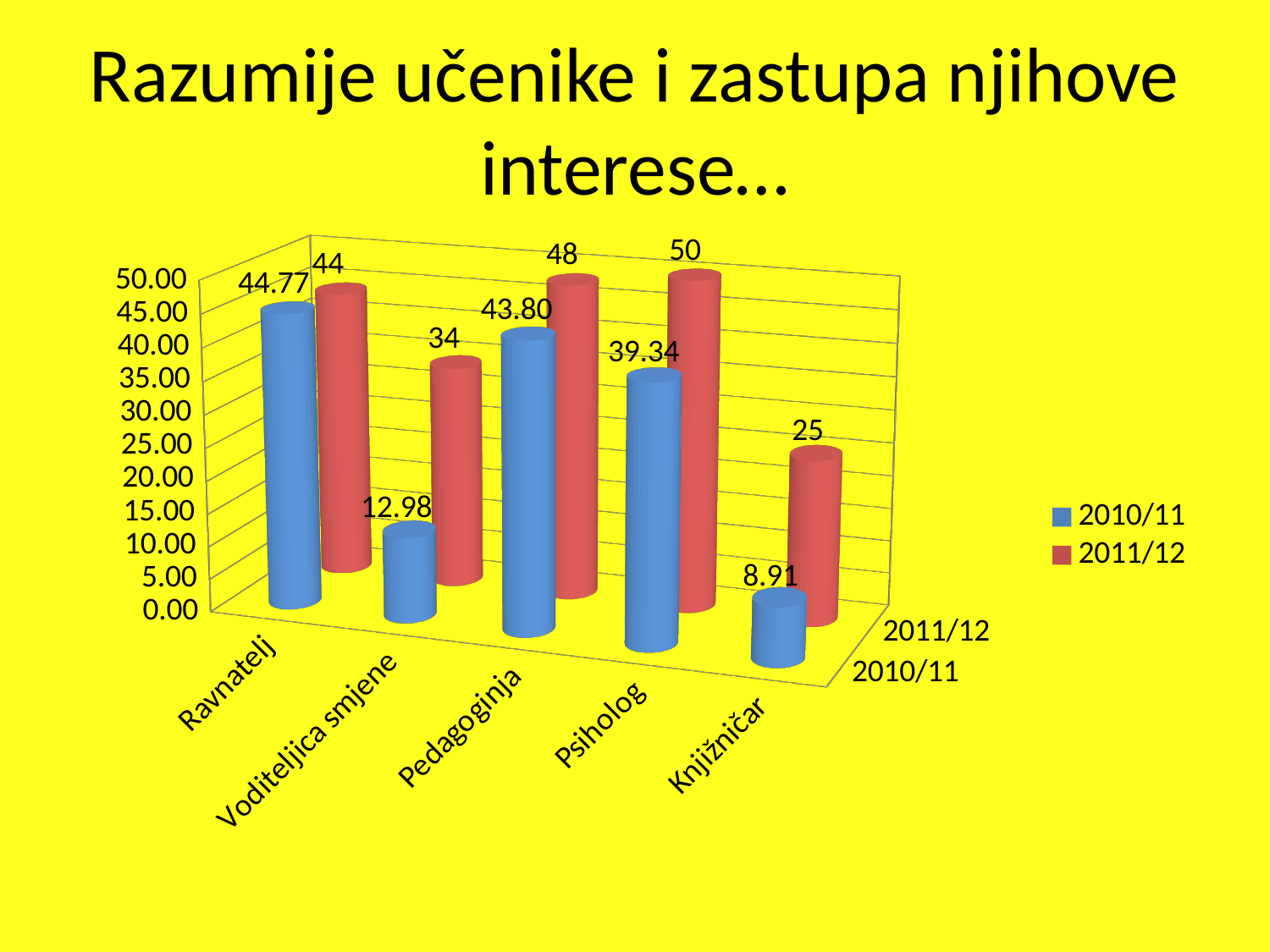
What kind of chart is shown on the slide? Bar chart How many series does the legend list? 2 What is the value for Psiholog in the 2011/12 series? 50 Which category has the lowest value in the 2010/11 series? Knjižničar What is the value for Ravnatelj in the 2010/11 series? 44.77 What is the value for Voditeljica smjene in the 2011/12 series? 34 Which is larger for Pedagoginja: the 2010/11 value or the 2011/12 value? 2011/12 How many categories are shown on the x axis? 5 What is the difference between the 2011/12 and 2010/11 values for Voditeljica smjene? 21.02 Which category has the highest value in the 2011/12 series? Psiholog What is the value for Knjižničar in the 2010/11 series? 8.91 Which series is shown in red in the legend? 2011/12